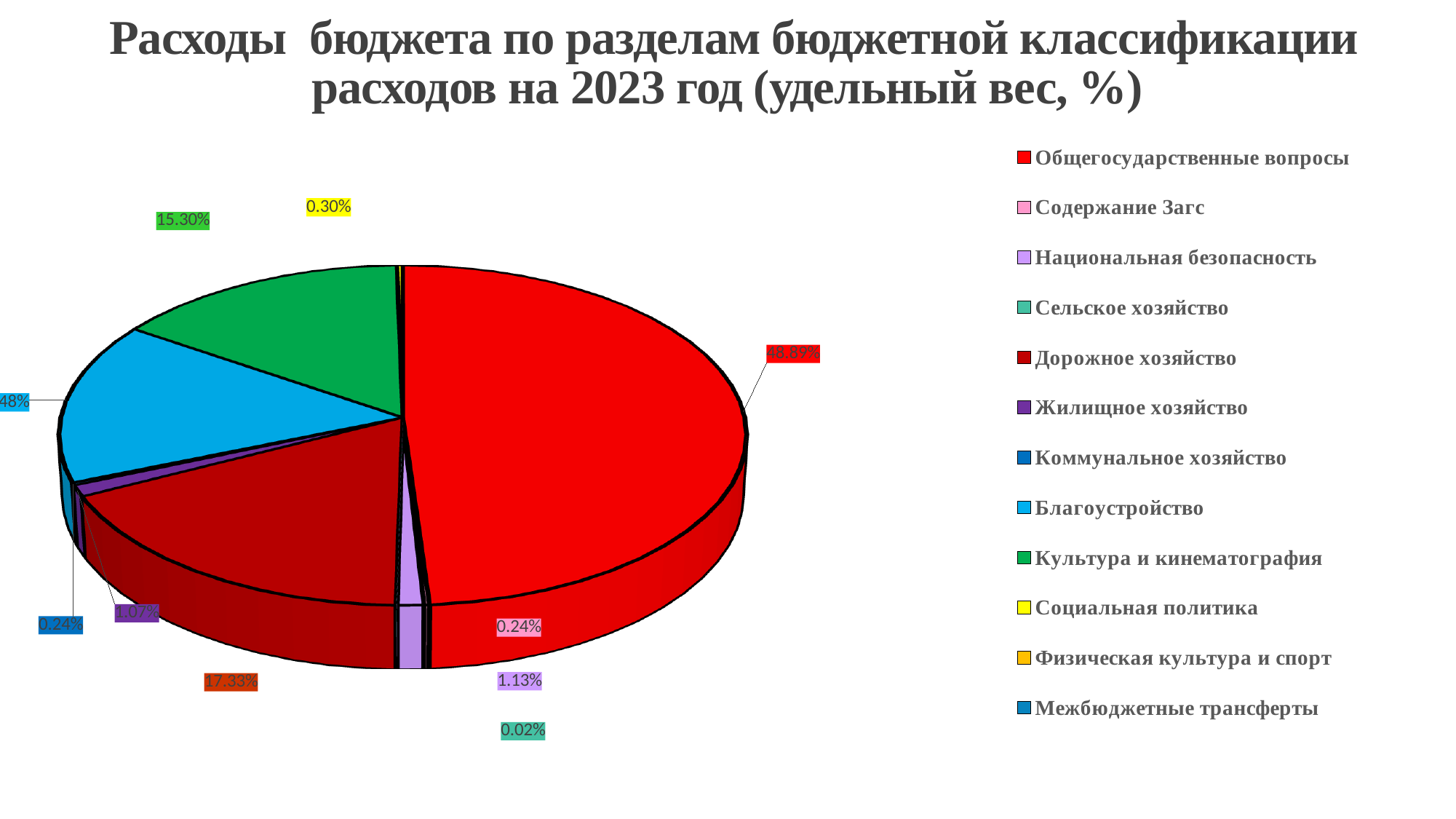
Which is larger, Дорожное хозяйство or Культура и кинематография? Дорожное хозяйство What is the value shown for Культура и кинематография? 15.30% What is the value shown for Национальная безопасность? 1.13% What is the value shown for Жилищное хозяйство? 1.07% What is the value shown for Социальная политика? 0.30% What is the value shown for Дорожное хозяйство? 17.33% What share of the pie does Общегосударственные вопросы have? 48.89% What is the difference between the values for Общегосударственные вопросы and Дорожное хозяйство? 31.56% What kind of chart is shown on the slide? pie chart Which category has the largest slice of the pie? Общегосударственные вопросы What colour is the slice for Общегосударственные вопросы? red How many categories does the legend list? 12